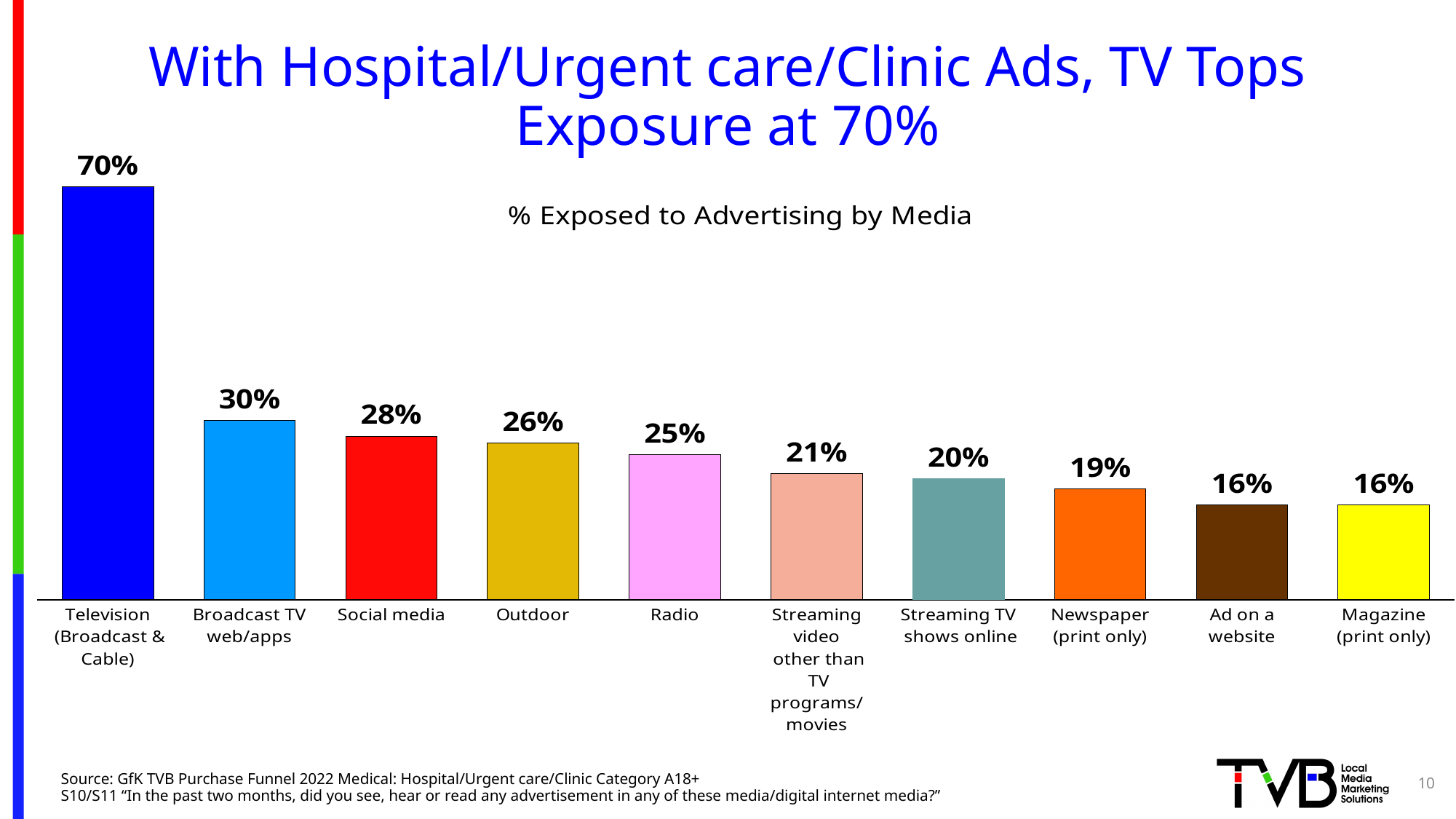
How many media categories are shown on the chart? 10 What is the lowest value shown on the chart? 16% Do the values rise or fall moving from left to right along the x axis? Fall What is the difference between the values for Social media and Streaming TV shows online? 8% Which media category has the highest exposure value? Television (Broadcast & Cable) What is the value for Radio? 25% What is the subtitle printed above the chart? % Exposed to Advertising by Media What percentage is shown for Television (Broadcast & Cable)? 70% What is the difference between the values for Television (Broadcast & Cable) and Broadcast TV web/apps? 40% What percentage is shown for Newspaper (print only)? 19% Which is larger, the value for Outdoor or the value for Streaming video other than TV programs/movies? Outdoor What kind of chart is shown on the slide? Bar chart